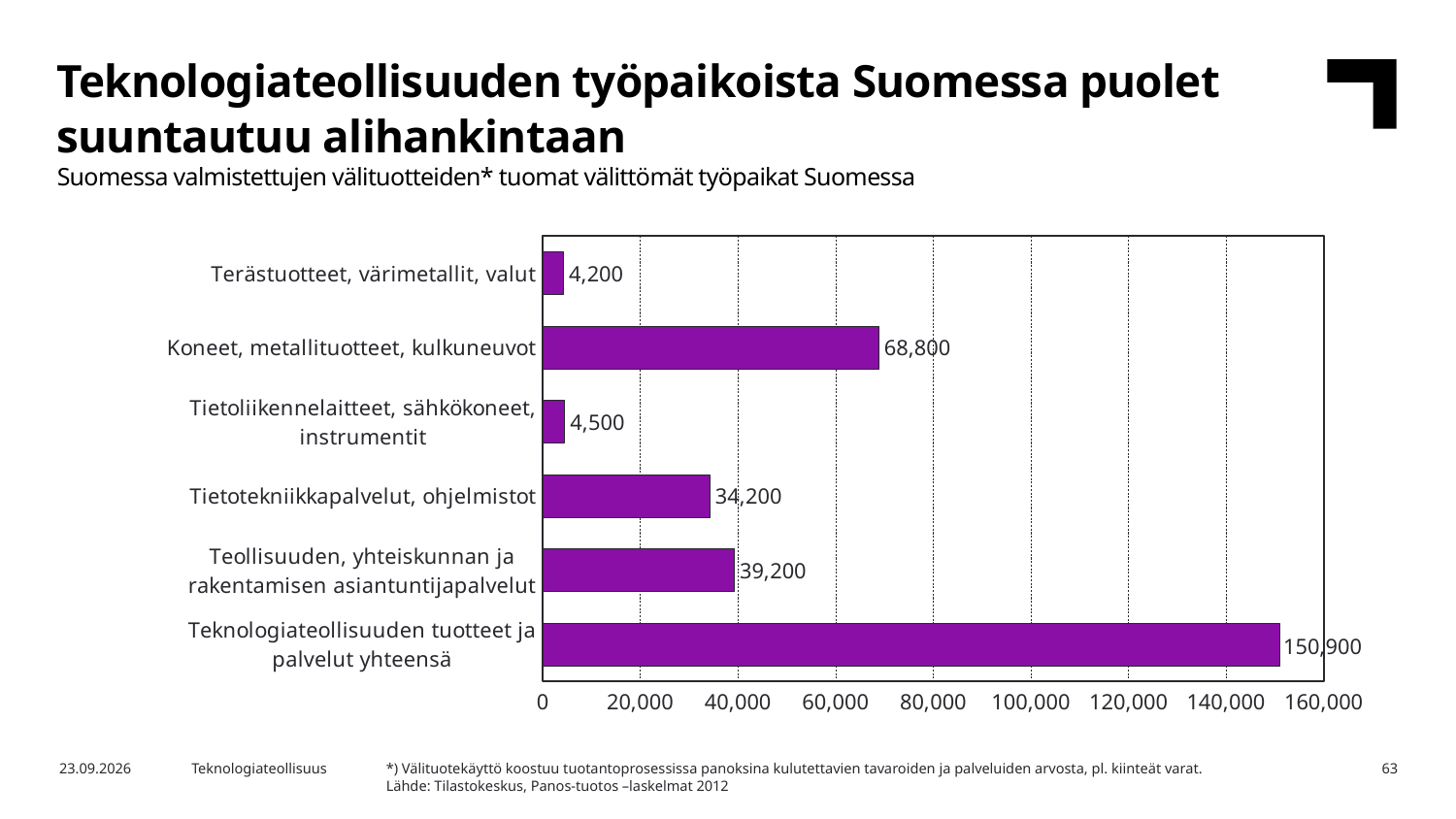
How many categories are shown in the chart? 6 What is the difference between Koneet, metallituotteet, kulkuneuvot and Tietotekniikkapalvelut, ohjelmistot? 34,600 What is the difference between Teollisuuden, yhteiskunnan ja rakentamisen asiantuntijapalvelut and Tietotekniikkapalvelut, ohjelmistot? 5,000 What is the value for Tietoliikennelaitteet, sähkökoneet, instrumentit? 4,500 Which category has the lowest value? Terästuotteet, värimetallit, valut What kind of chart is shown on the slide? bar chart Is the value for Koneet, metallituotteet, kulkuneuvot greater or less than 60,000? greater Which category has the highest value? Teknologiateollisuuden tuotteet ja palvelut yhteensä What is the value for Koneet, metallituotteet, kulkuneuvot? 68,800 What is the value for Teknologiateollisuuden tuotteet ja palvelut yhteensä? 150,900 What is the value for Tietotekniikkapalvelut, ohjelmistot? 34,200 Which is larger: Koneet, metallituotteet, kulkuneuvot or Teollisuuden, yhteiskunnan ja rakentamisen asiantuntijapalvelut? Koneet, metallituotteet, kulkuneuvot